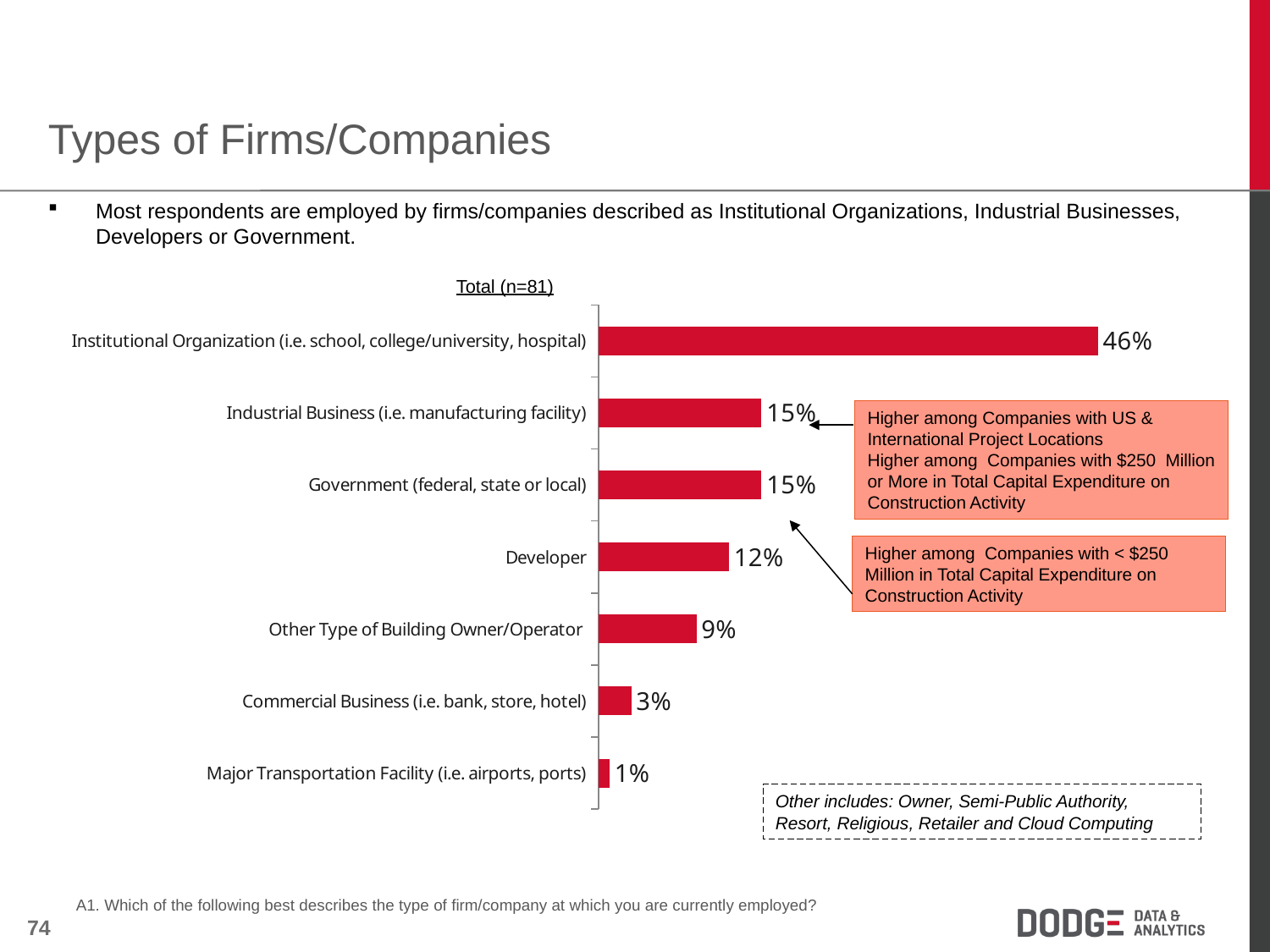
How many categories are shown in the chart? 7 What is the sample size shown in the chart's label? n=81 What is the value for Commercial Business (i.e. bank, store, hotel)? 3% Which two categories share the same value of 15%? Industrial Business (i.e. manufacturing facility) and Government (federal, state or local) Which category has the highest value? Institutional Organization (i.e. school, college/university, hospital) What percentage of respondents are employed by an Institutional Organization? 46% What is the difference between the values for Institutional Organization and Industrial Business? 31% Which category has the lowest value? Major Transportation Facility (i.e. airports, ports) What is the difference between the values for Developer and Other Type of Building Owner/Operator? 3% Which is larger, the value for Developer or the value for Government (federal, state or local)? Government (federal, state or local) What is the value for Developer? 12% What kind of chart is shown on the slide? Bar chart